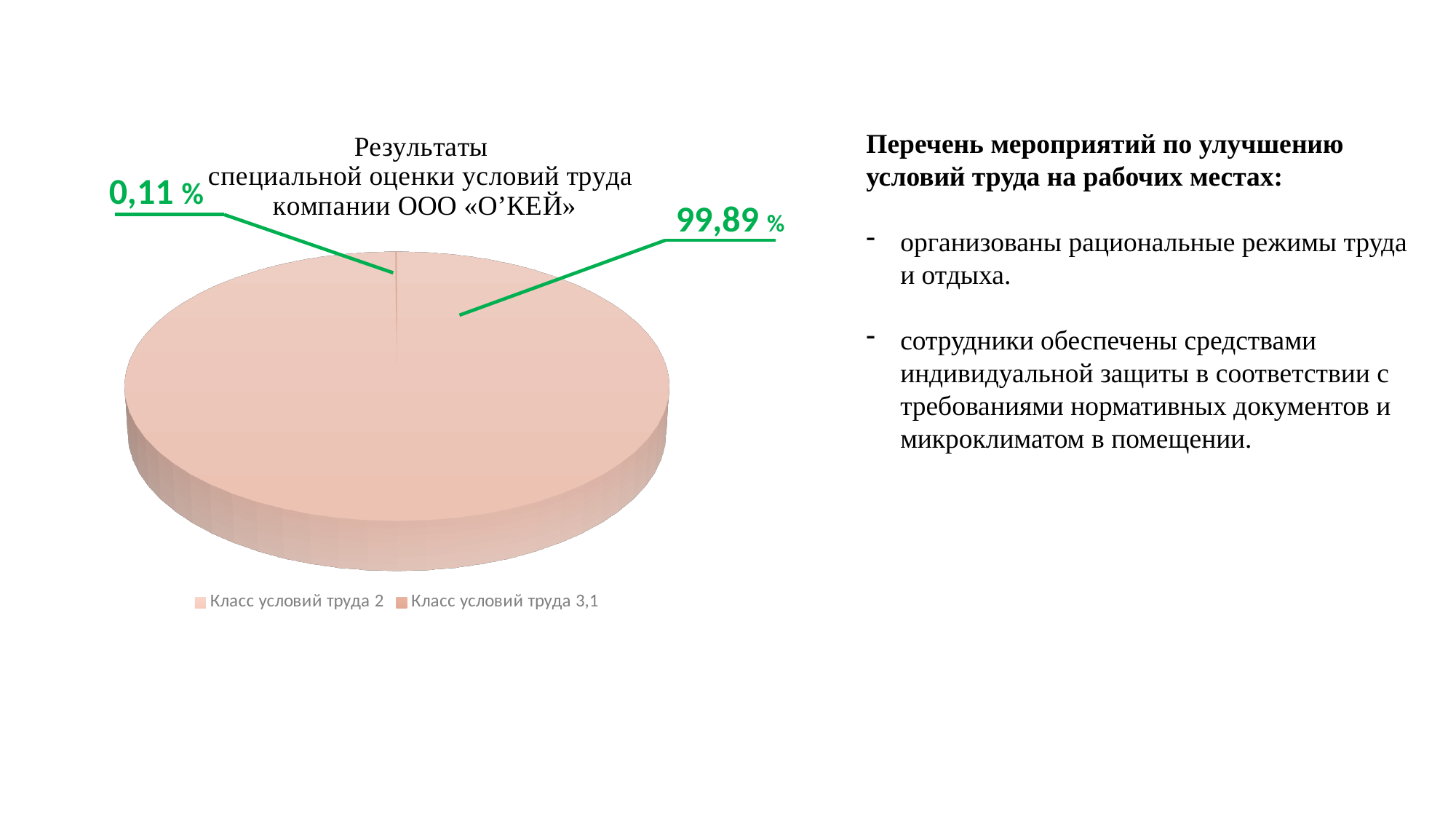
What is the title of the pie chart? Результаты специальной оценки условий труда компании ООО «О’КЕЙ» What is the value of the smallest slice in the pie chart? 0,11 % What share of the pie does "Класс условий труда 3,1" take? 0,11 % What is the value of the largest slice in the pie chart? 99,89 % Which slice is larger: "Класс условий труда 2" or "Класс условий труда 3,1"? Класс условий труда 2 What is the difference between the two slices of the pie chart, 99,89 % and 0,11 %? 99,78 % What share of the pie does "Класс условий труда 2" take? 99,89 % What kind of chart is shown on the slide? Pie chart How many slices does the pie chart have? 2 What are the two legend entries of the pie chart? Класс условий труда 2; Класс условий труда 3,1 How many entries does the legend of the pie chart list? 2